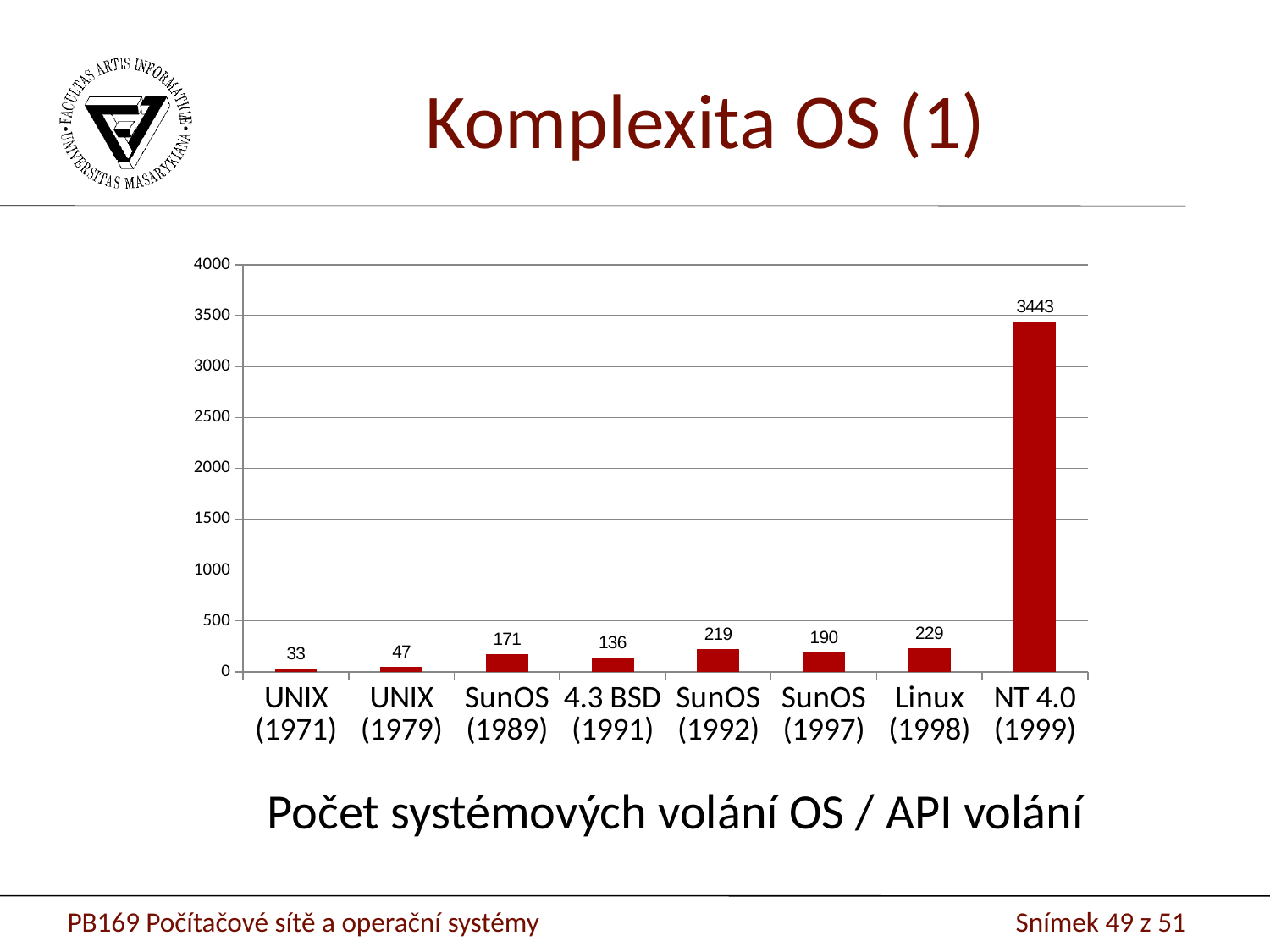
What is the difference between the values for SunOS (1992) and SunOS (1997)? 29 Which category has the highest value? NT 4.0 (1999) Which is larger, the value for SunOS (1989) or the value for 4.3 BSD (1991)? SunOS (1989) What is the value for UNIX (1971)? 33 What is the caption text shown below the chart? Počet systémových volání OS / API volání How many categories are shown on the x axis? 8 Which category has the lowest value? UNIX (1971) What is the difference between the values for UNIX (1979) and UNIX (1971)? 14 What is the value for 4.3 BSD (1991)? 136 What is the value for NT 4.0 (1999)? 3443 What kind of chart is shown on the slide? bar chart What is the value for Linux (1998)? 229